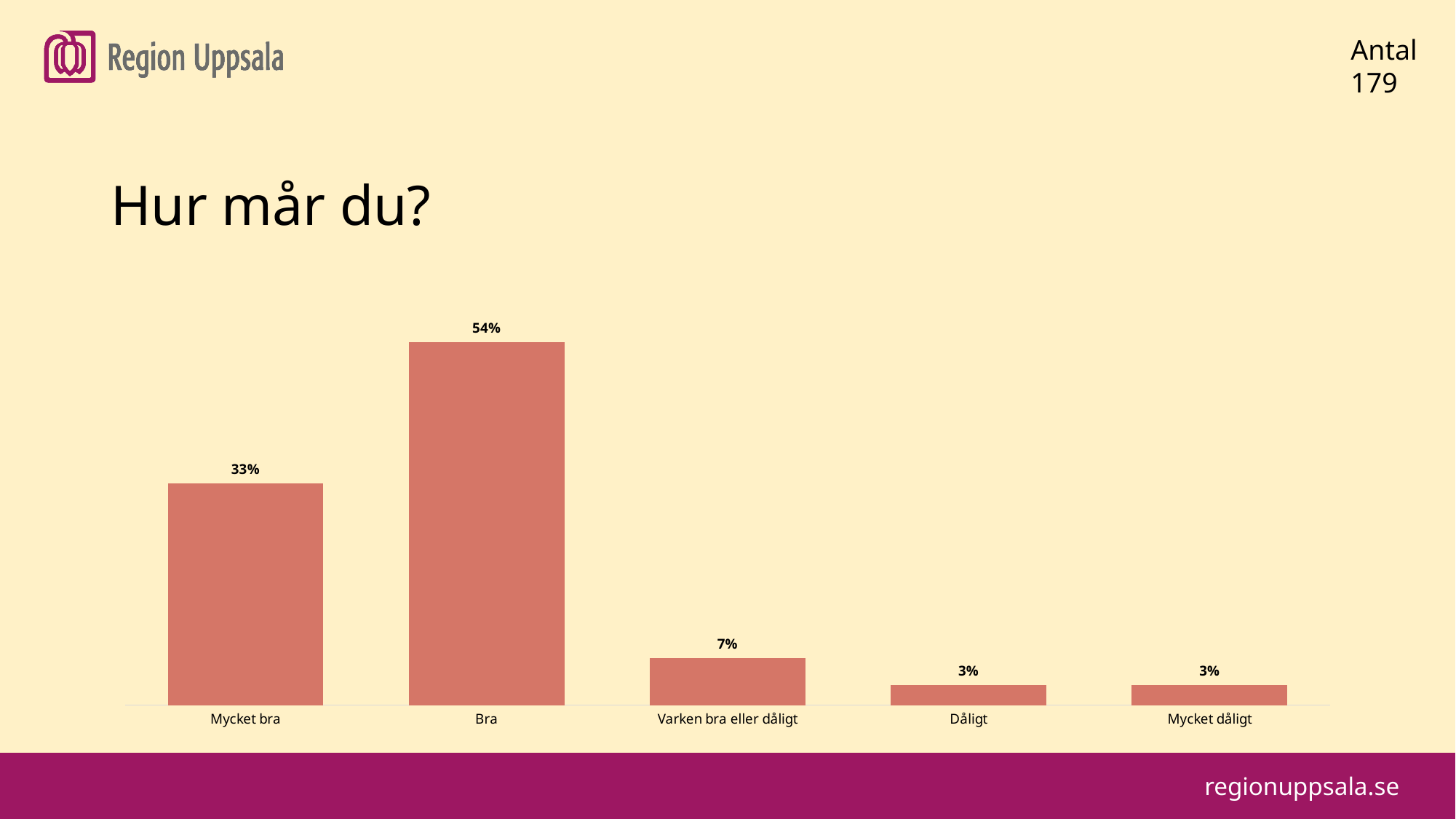
What is the value for "Dåligt"? 3% What kind of chart is shown on the slide? Bar chart What is the value for "Bra"? 54% What is the difference between the values for "Bra" and "Mycket bra"? 21% Which category has the highest value? Bra What is the difference between the values for "Varken bra eller dåligt" and "Dåligt"? 4% Which is larger, the value for "Mycket bra" or the value for "Varken bra eller dåligt"? Mycket bra How many categories are shown on the x axis? 5 What is the value for "Mycket bra"? 33% What is the title of the slide above the chart? Hur mår du? What number of respondents (Antal) is shown on the slide? 179 What is the value for "Varken bra eller dåligt"? 7%